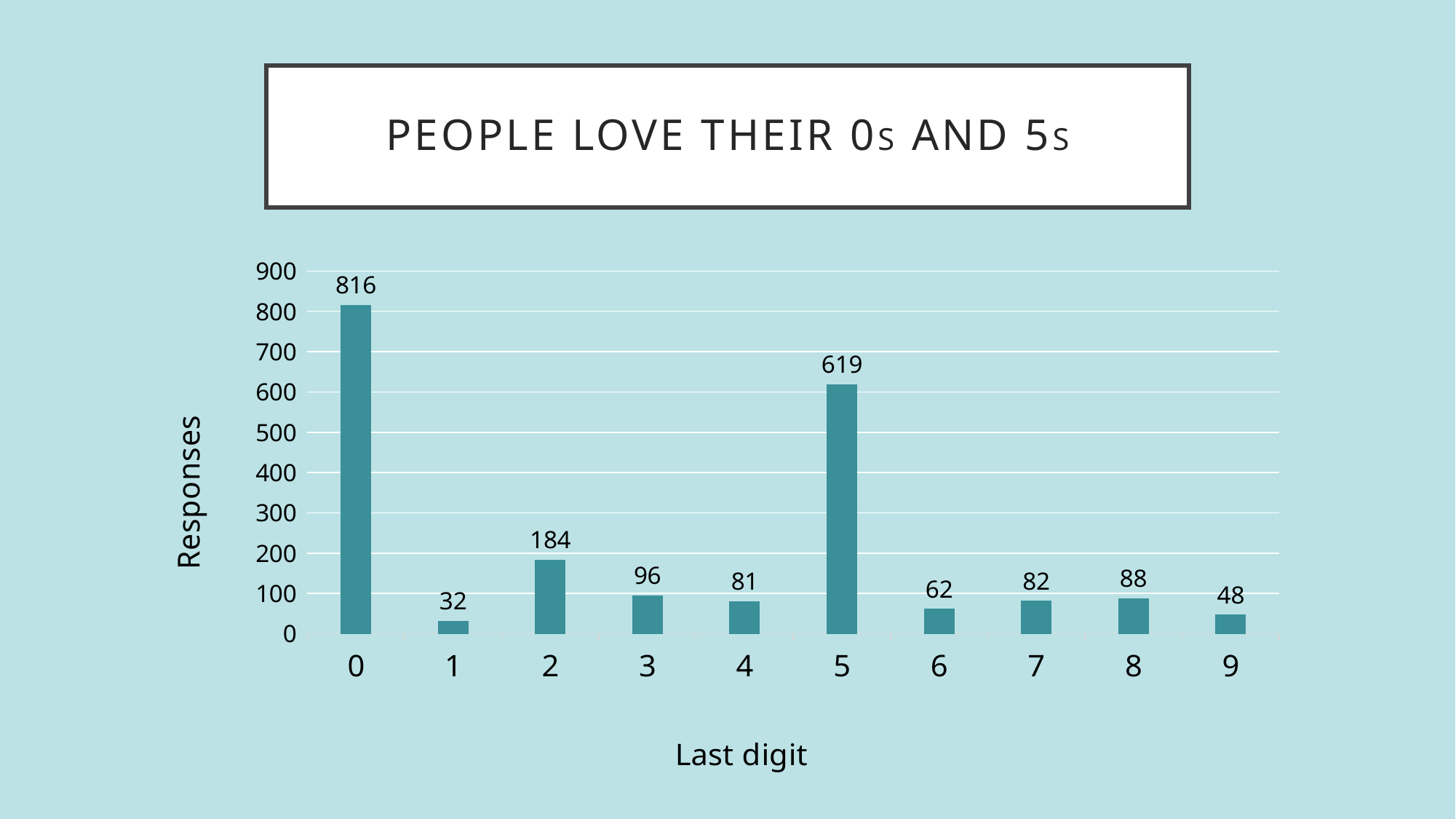
What is the number of responses for last digit 5? 619 What is the label of the y axis? Responses Which last digit has the most responses? 0 What is the difference in responses between last digit 0 and last digit 5? 197 How many last-digit categories are shown on the x axis? 10 What is the title of the slide? PEOPLE LOVE THEIR 0s AND 5s How many responses are shown for last digit 2? 184 Which last digit has the fewest responses? 1 What kind of chart is shown on the slide? Bar chart Which has more responses, last digit 3 or last digit 9? 3 Is the value for last digit 2 greater or less than 100? greater How many responses had a last digit of 0? 816